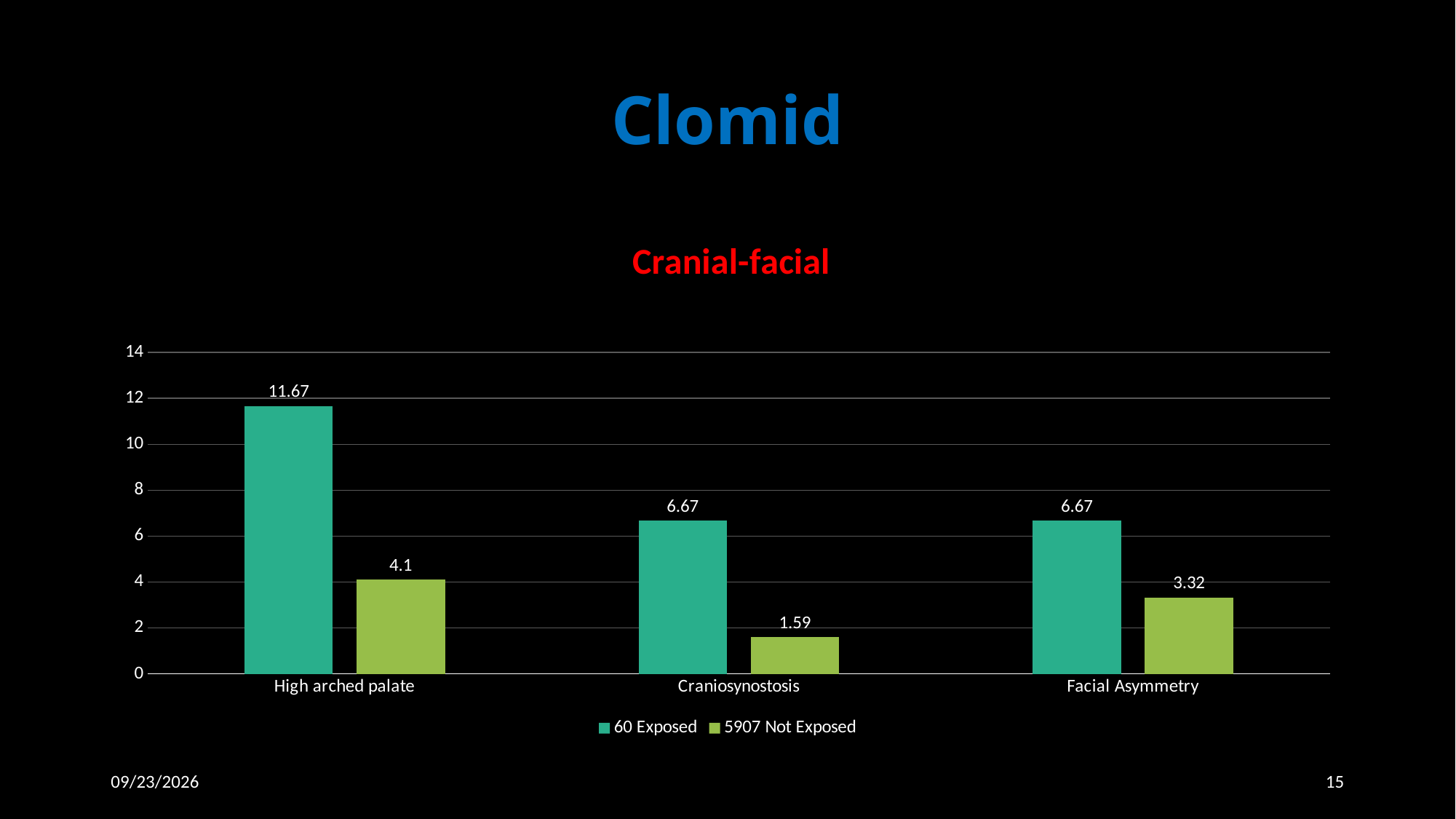
What is the value for 5907 Not Exposed in the Craniosynostosis category? 1.59 What is the value for 60 Exposed in the High arched palate category? 11.67 What is the value for 60 Exposed in the Craniosynostosis category? 6.67 How many categories are shown on the x axis? 3 What kind of chart is shown on the slide? Bar chart What is the title of the chart? Cranial-facial What is the value for 5907 Not Exposed in the Facial Asymmetry category? 3.32 How many series does the legend list? 2 Which category has the lowest value for the 5907 Not Exposed series? Craniosynostosis What is the difference between the 60 Exposed and 5907 Not Exposed values for High arched palate? 7.57 Which category has the highest value for the 60 Exposed series? High arched palate Which is larger: the 5907 Not Exposed value for High arched palate or for Facial Asymmetry? High arched palate